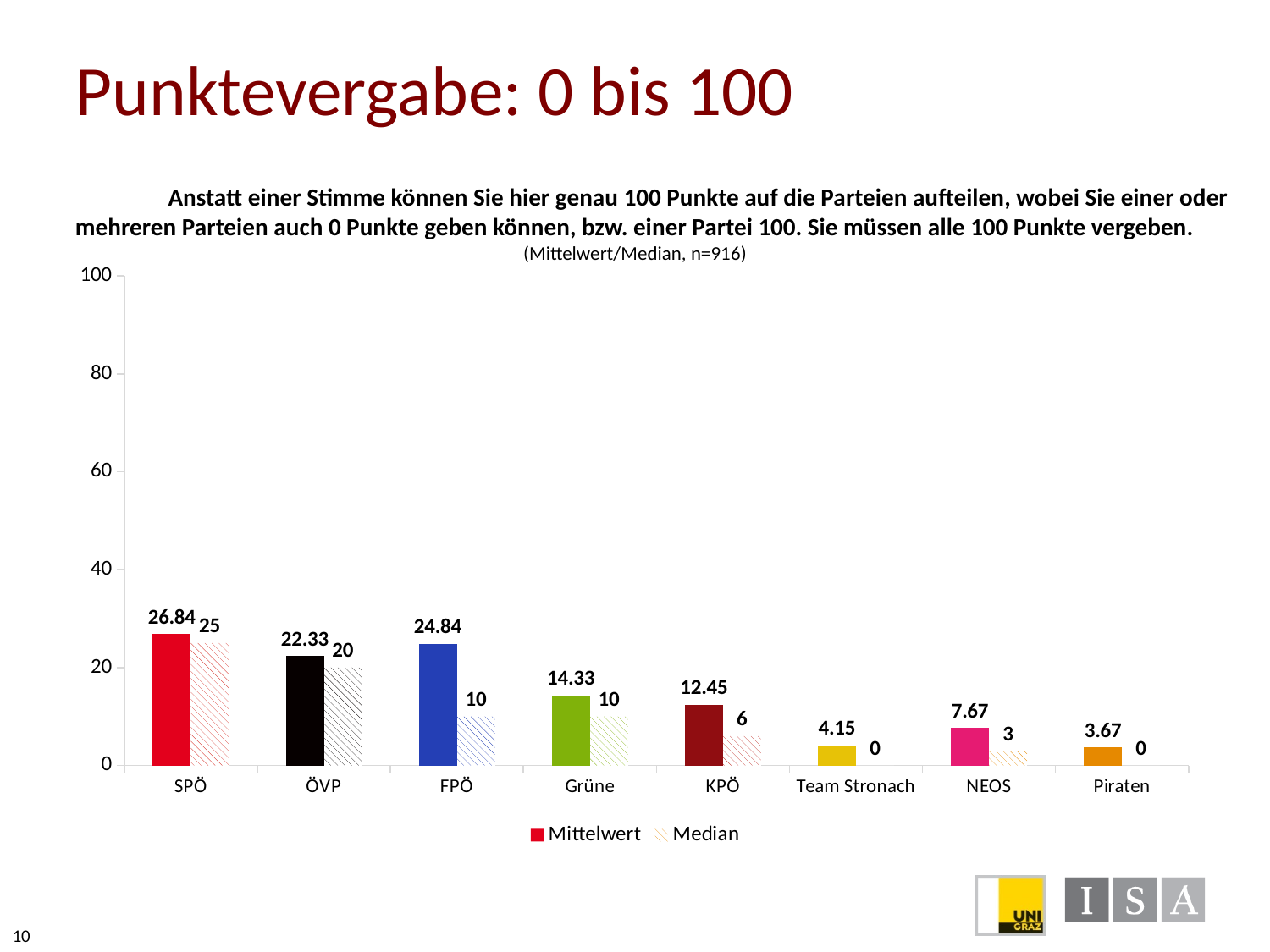
What is the Mittelwert value for Grüne? 14.33 What are the two series named in the legend? Mittelwert and Median What is the difference between the Mittelwert values for SPÖ and FPÖ? 2 What is the Median value for ÖVP? 20 What is the Mittelwert value for SPÖ? 26.84 What kind of chart is shown on the slide? Bar chart Which party has the highest Mittelwert value? SPÖ What is the Median value for KPÖ? 6 Which party has the lowest Mittelwert value? Piraten Which is larger, the Mittelwert value for ÖVP or for FPÖ? FPÖ How many series does the legend list? 2 How many parties are shown on the x axis? 8